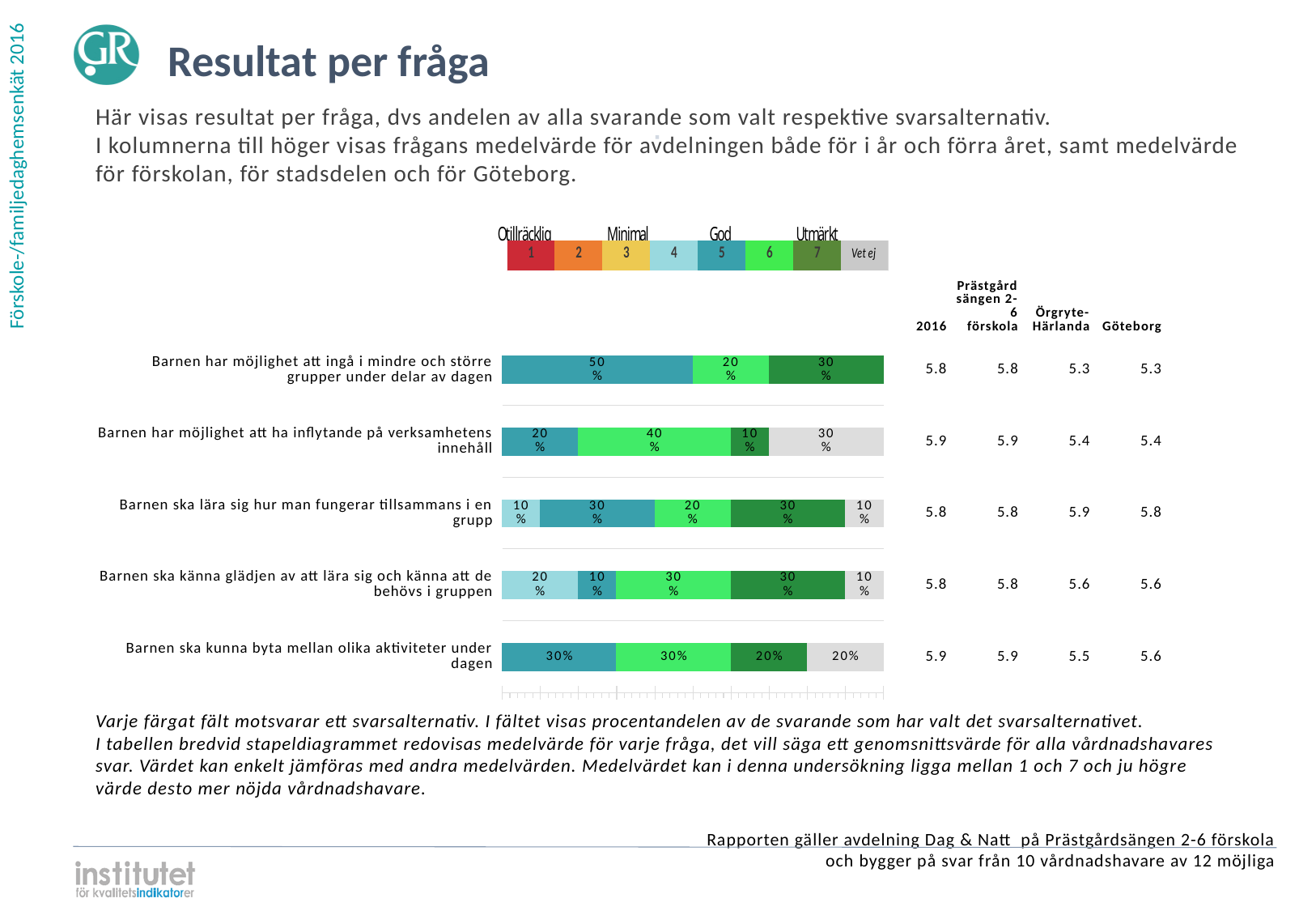
Which is larger: the 2016 mean for 'Barnen har möjlighet att ha inflytande på verksamhetens innehåll' or the Göteborg mean for the same question? 2016 mean (5.9) What is the Göteborg mean value shown for 'Barnen har möjlighet att ingå i mindre och större grupper under delar av dagen'? 5.3 What percentage is shown for the light grey 'Vet ej' segment of the bar for 'Barnen ska kunna byta mellan olika aktiviteter under dagen'? 20% What percentage is shown for the first (teal) segment of the bar for 'Barnen har möjlighet att ingå i mindre och större grupper under delar av dagen'? 50% What is the Örgryte-Härlanda mean value shown for 'Barnen ska lära sig hur man fungerar tillsammans i en grupp'? 5.9 What kind of chart is shown on the slide? Stacked bar chart How many questions (categories) are plotted in the bar chart? 5 What is the difference between the first segment (50%) and the second segment (20%) of the bar for 'Barnen har möjlighet att ingå i mindre och större grupper under delar av dagen'? 30% How many answer alternatives does the colour legend above the chart show, including 'Vet ej'? 8 What percentage is shown for the light grey 'Vet ej' segment of the bar for 'Barnen har möjlighet att ha inflytande på verksamhetens innehåll'? 30% Which question has the largest single segment in its bar? Barnen har möjlighet att ingå i mindre och större grupper under delar av dagen What is the 2016 mean value shown for 'Barnen ska kunna byta mellan olika aktiviteter under dagen'? 5.9